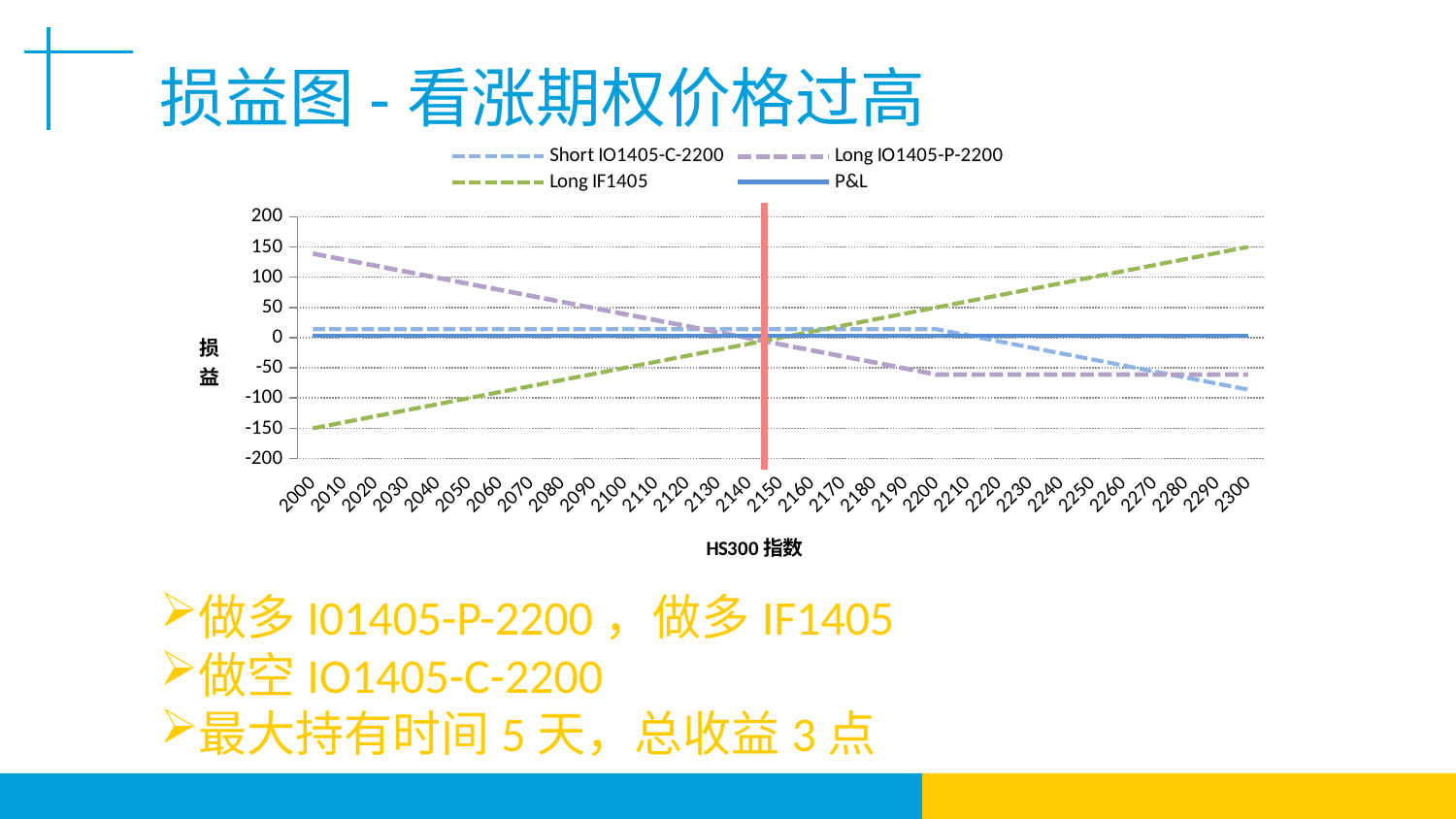
How many series does the chart legend list? 4 How many HS300 index values are labelled along the x axis of the chart? 31 Is the value of Short IO1405-C-2200 at an HS300 index of 2300 greater or less than -50? less Does the Long IO1405-P-2200 series rise or fall as the HS300 index increases? fall Which series has the highest value at an HS300 index of 2300? Long IF1405 What is the title of the x axis of the chart? HS300 指数 Is the value of Long IO1405-P-2200 at an HS300 index of 2000 greater or less than 100? greater What is the value of the Long IF1405 series at an HS300 index of 2300? 150 What is the value of the Long IF1405 series at an HS300 index of 2000? -150 Does the Long IF1405 series rise or fall as the HS300 index increases? rise At an HS300 index of 2000, which is larger: Long IO1405-P-2200 or Long IF1405? Long IO1405-P-2200 What kind of chart is shown on the slide? line chart